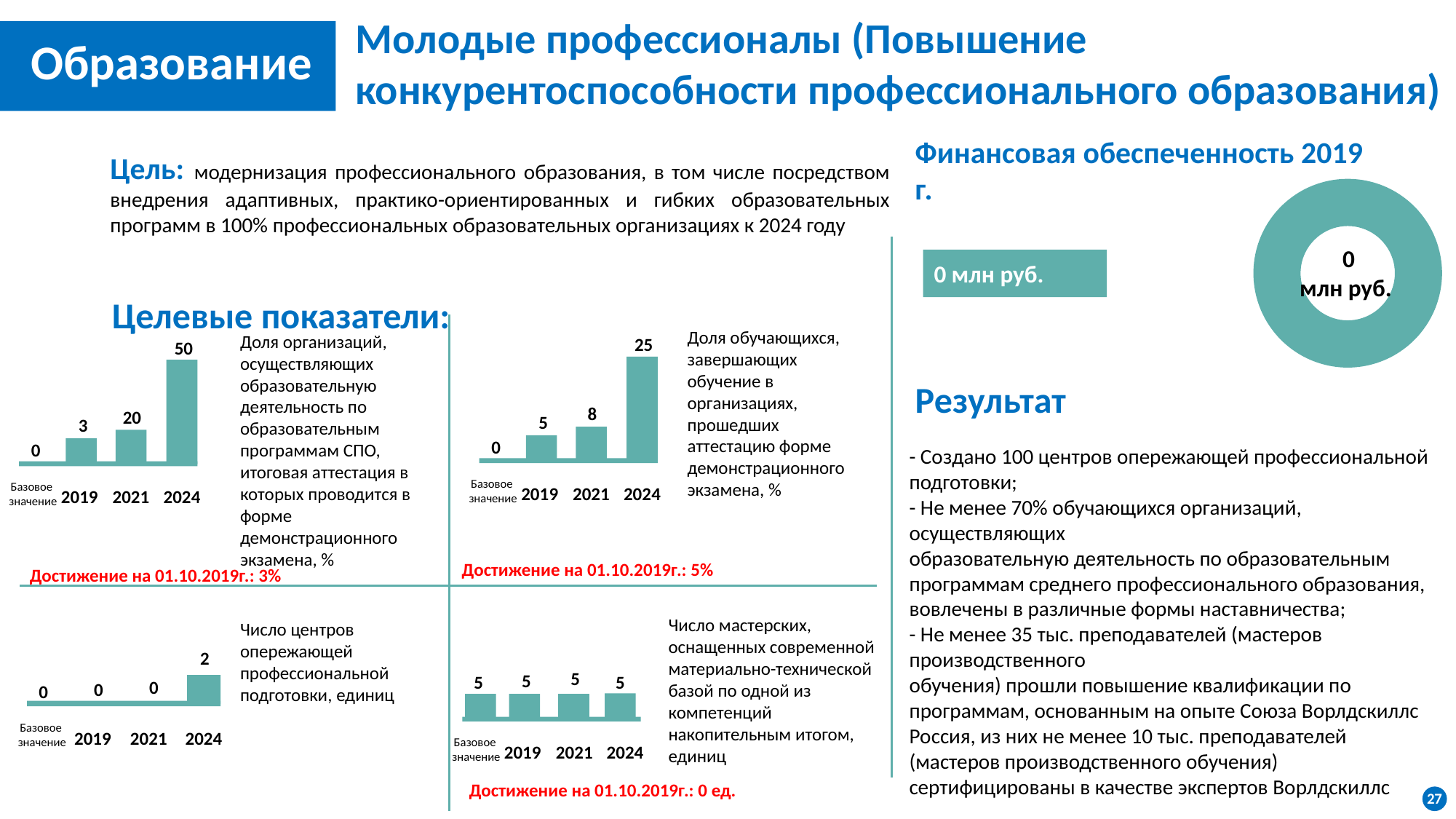
In the top-left bar chart (Доля организаций...), what is the value for 2021? 20 In the top-middle bar chart (Доля обучающихся...), which year has the highest value? 2024 In the top-left bar chart (Доля организаций...), what is the difference between the 2024 value and the 2019 value? 47 In the bottom-middle bar chart (Число мастерских...), do the values rise, fall or stay the same across the x axis? stay the same In the top-left bar chart (Доля организаций, осуществляющих образовательную деятельность по образовательным программам СПО...), what is the value for 2024? 50 In the top-middle bar chart (Доля обучающихся, завершающих обучение...), what is the value for 2021? 8 In the bottom-left bar chart (Число центров опережающей профессиональной подготовки), how many categories are shown on the x axis? 4 What kind of chart is shown under the heading Финансовая обеспеченность 2019 г.? donut (pie) chart In the top-middle bar chart (Доля обучающихся...), what is the difference between the 2024 value and the 2021 value? 17 In the bottom-middle bar chart (Число мастерских, оснащенных современной материально-технической базой...), what is the value for 2019? 5 In the bottom-left bar chart (Число центров опережающей профессиональной подготовки), what is the value for 2024? 2 In the top-left bar chart (Доля организаций...), do the values rise or fall from the base value to 2024? rise